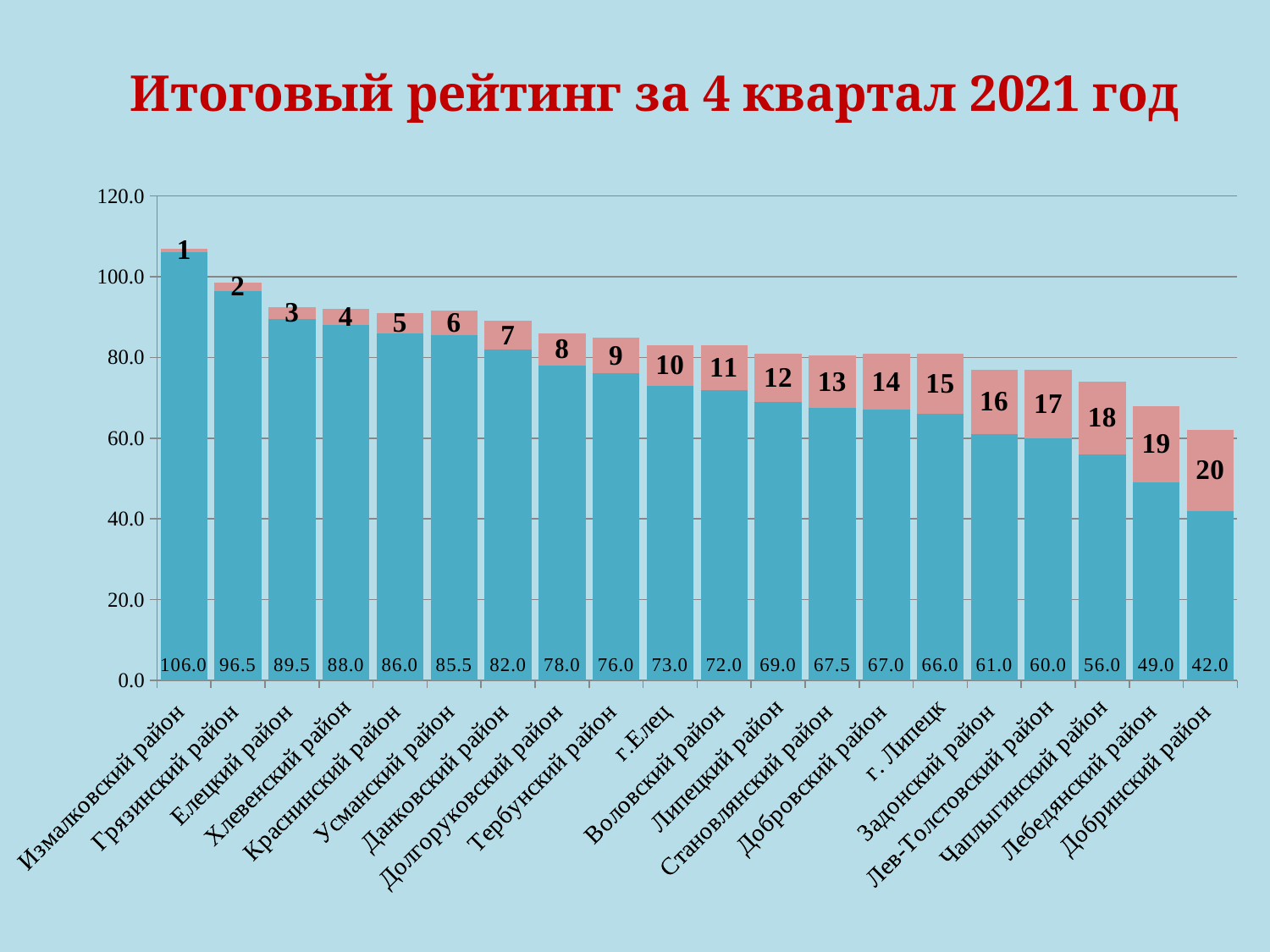
What is the difference between the values for Грязинский район and Елецкий район? 7.0 Do the values rise or fall from left to right along the x axis? fall Which category has the lowest value? Добринский район What is the value shown for Измалковский район? 106.0 What is the value shown for Добринский район? 42.0 How many categories are shown on the x axis? 20 What is the value shown for Лев-Толстовский район? 60.0 What is the value shown for г.Елец? 73.0 Which has a larger value, Усманский район or Тербунский район? Усманский район What kind of chart is shown on the slide? bar chart Which category has the highest value? Измалковский район What is the title of the slide? Итоговый рейтинг за 4 квартал 2021 год